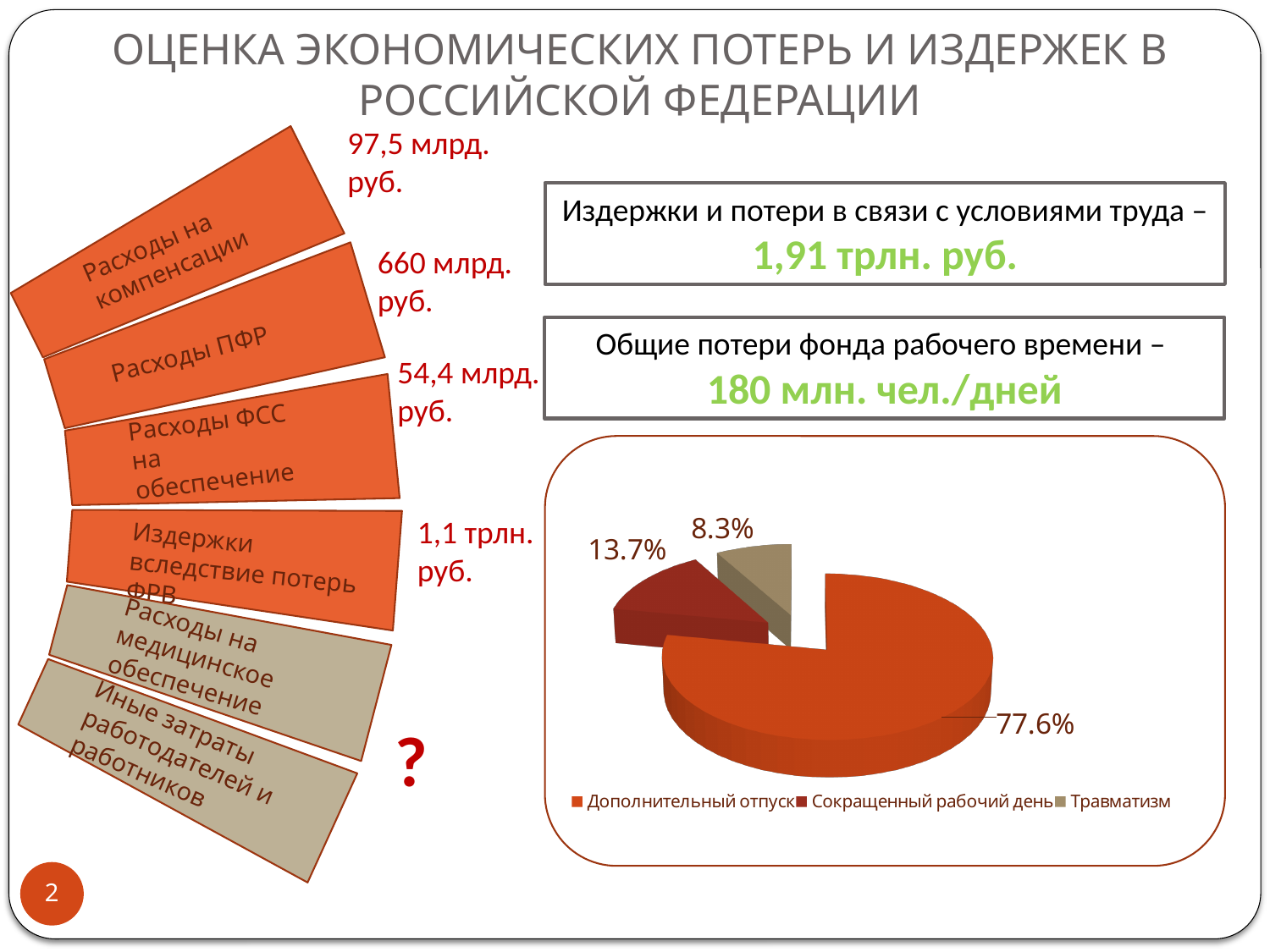
What type of chart is shown on the right side of the slide? Pie chart Which category has the largest slice in the pie chart? Дополнительный отпуск What share of the pie chart does Сокращенный рабочий день account for? 13.7% How many entries does the pie chart's legend list? 3 What share of the pie chart does Травматизм account for? 8.3% What is the difference in percentage points between Сокращенный рабочий день and Травматизм in the pie chart? 5.4 What is the difference in percentage points between Дополнительный отпуск and Сокращенный рабочий день in the pie chart? 63.9 How many slices does the pie chart have? 3 What share of the pie chart does Дополнительный отпуск account for? 77.6% In the pie chart, which is larger: Сокращенный рабочий день or Травматизм? Сокращенный рабочий день What colour is the Травматизм slice in the pie chart? Beige (tan) Which category has the smallest slice in the pie chart? Травматизм